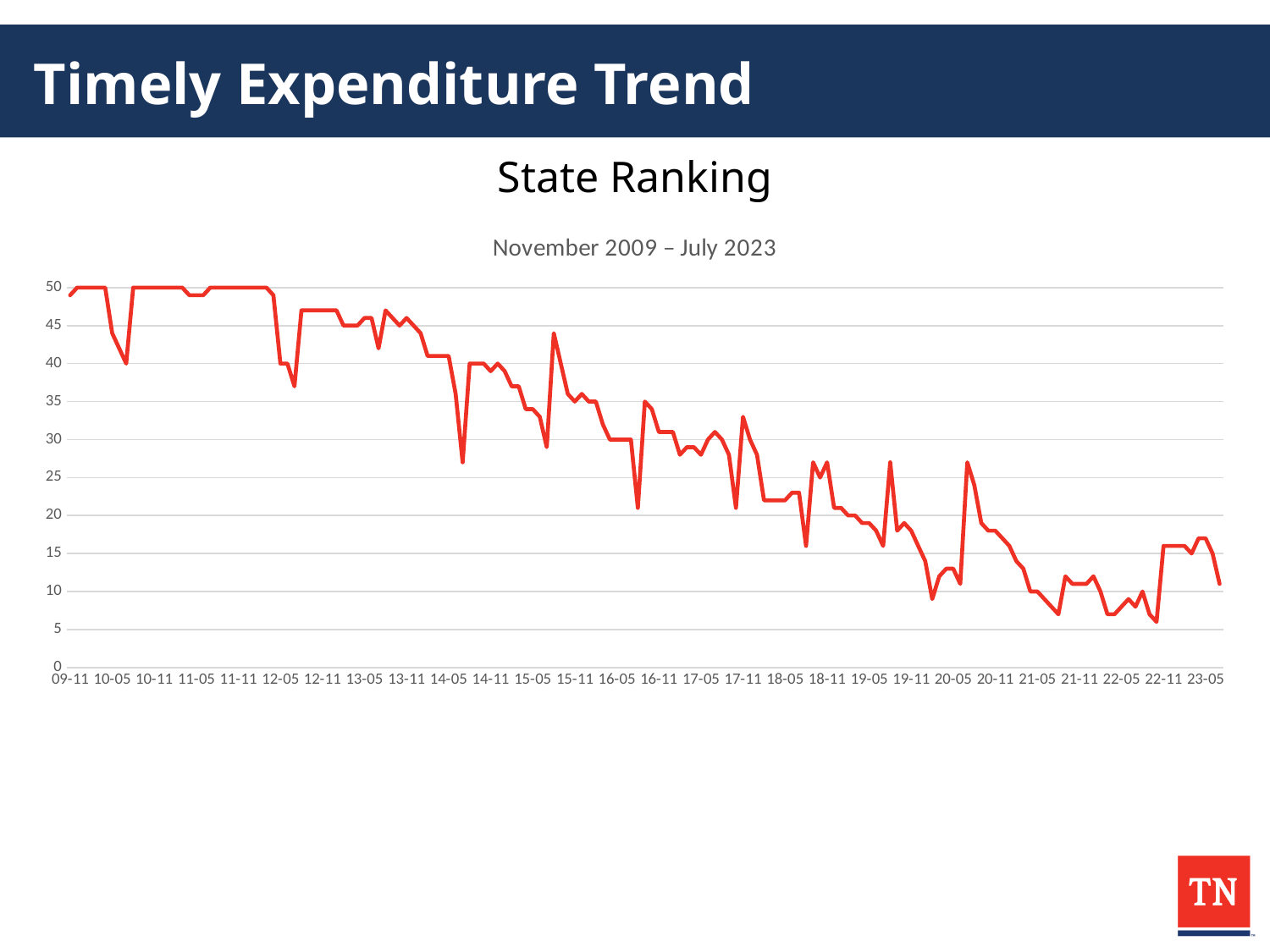
Is the value at 14-05 greater or less than 30? greater Is the value at 12-05 greater or less than 45? less What date range does the chart's subtitle give? November 2009 – July 2023 Which is larger, the value at 10-11 or the value at 20-11? 10-11 What kind of chart is shown on the slide? line chart Is the value at 22-11 greater or less than 10? greater Overall, does the state ranking line rise or fall from left to right across the chart? fall What is the highest value shown on the vertical axis? 50 What is the title of the chart? State Ranking